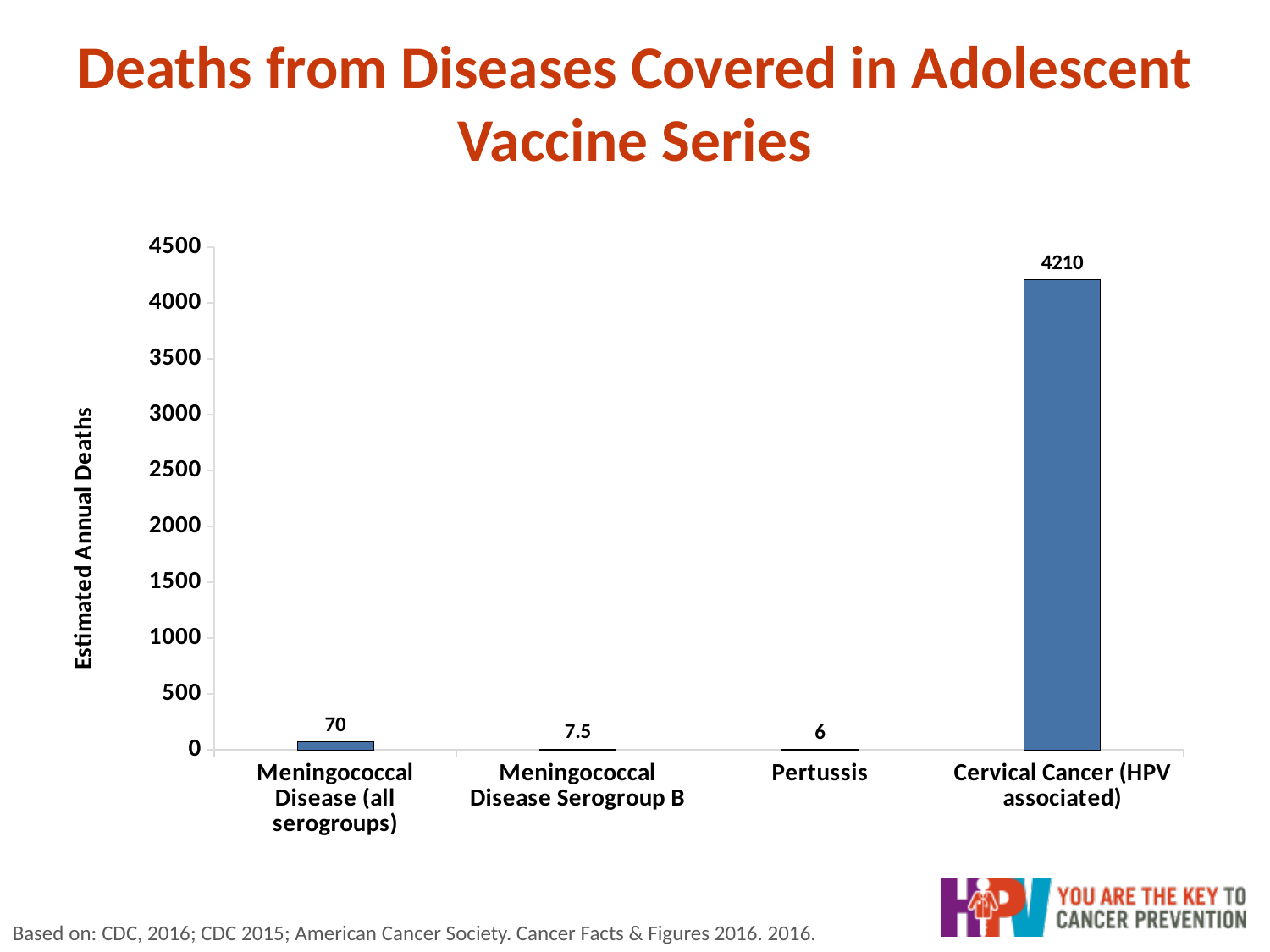
Which has more estimated annual deaths, Meningococcal Disease (all serogroups) or Pertussis? Meningococcal Disease (all serogroups) Is the value for Cervical Cancer (HPV associated) greater or less than 4000? greater What is the estimated annual number of deaths for Cervical Cancer (HPV associated)? 4210 What is the estimated annual number of deaths for Pertussis? 6 What is the difference in estimated annual deaths between Cervical Cancer (HPV associated) and Meningococcal Disease (all serogroups)? 4140 What is the estimated annual number of deaths for Meningococcal Disease (all serogroups)? 70 How many disease categories are shown on the chart? 4 What is the label of the vertical axis? Estimated Annual Deaths What kind of chart is shown on the slide? Bar chart Which disease has the highest estimated annual deaths? Cervical Cancer (HPV associated) Which disease has the lowest estimated annual deaths? Pertussis What is the estimated annual number of deaths for Meningococcal Disease Serogroup B? 7.5